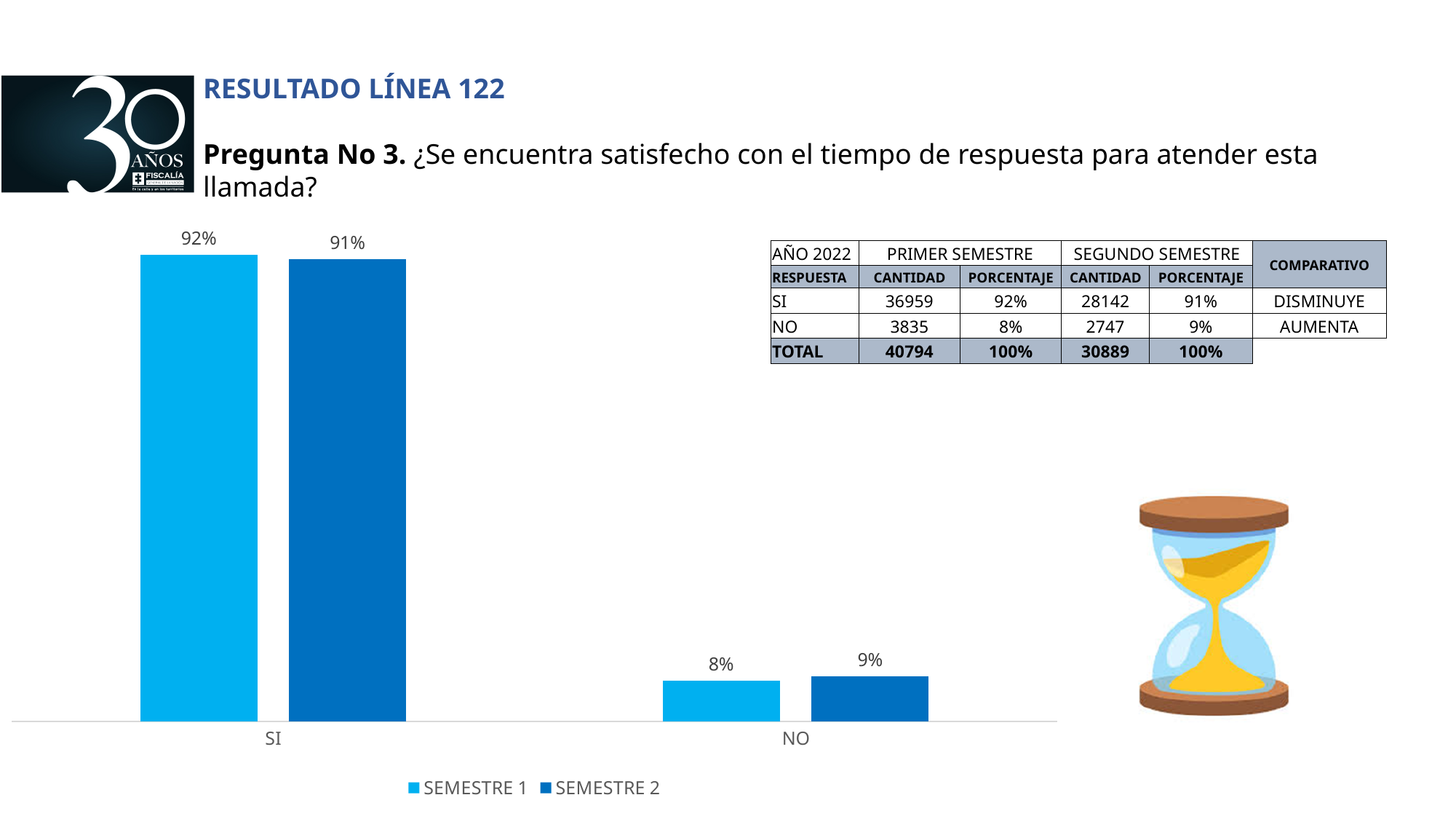
Which category has the highest value in SEMESTRE 1? SI How many categories are shown on the x axis of the chart? 2 What is the difference between the SI and NO values in SEMESTRE 1? 84% What kind of chart is shown on the slide? Bar chart What is the difference between the SI values for SEMESTRE 1 and SEMESTRE 2? 1% What is the value for SI in SEMESTRE 2? 91% Which category has the lowest value in SEMESTRE 2? NO What is the value for SI in SEMESTRE 1? 92% What is the value for NO in SEMESTRE 2? 9% How many series does the legend list? 2 What is the value for NO in SEMESTRE 1? 8% Which is larger: the NO value for SEMESTRE 1 or for SEMESTRE 2? SEMESTRE 2